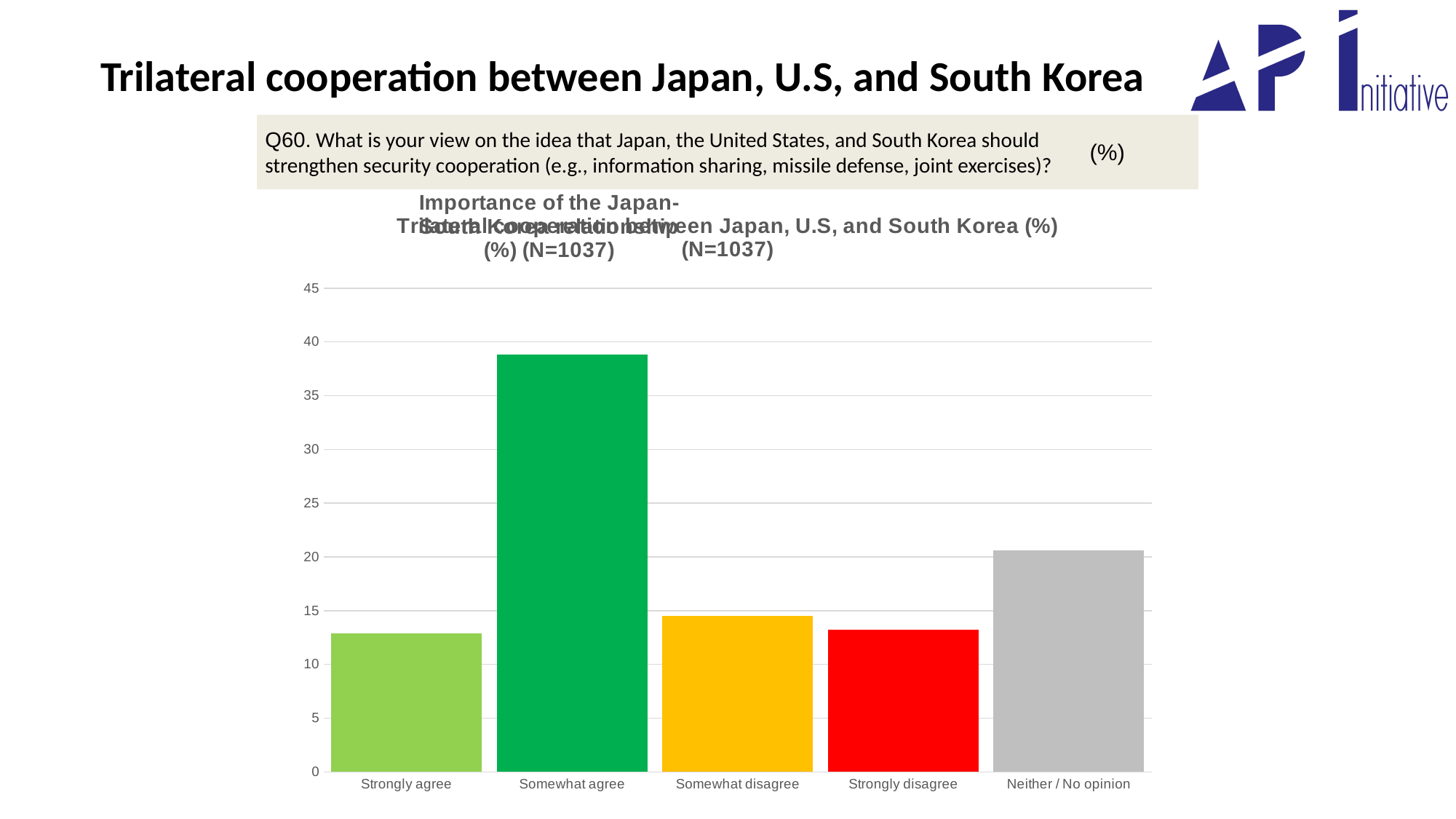
Is the value for Neither / No opinion greater or less than 25? less Which is larger, the value for Somewhat agree or the value for Neither / No opinion? Somewhat agree Is the value for Strongly disagree greater or less than 10? greater Which response category has the highest value in the chart? Somewhat agree Is the value for Neither / No opinion greater or less than 15? greater What colour is the bar for Neither / No opinion? grey Which is larger, the value for Neither / No opinion or the value for Somewhat disagree? Neither / No opinion What kind of chart is shown on the slide? bar chart How many response categories are shown on the x axis of the chart? 5